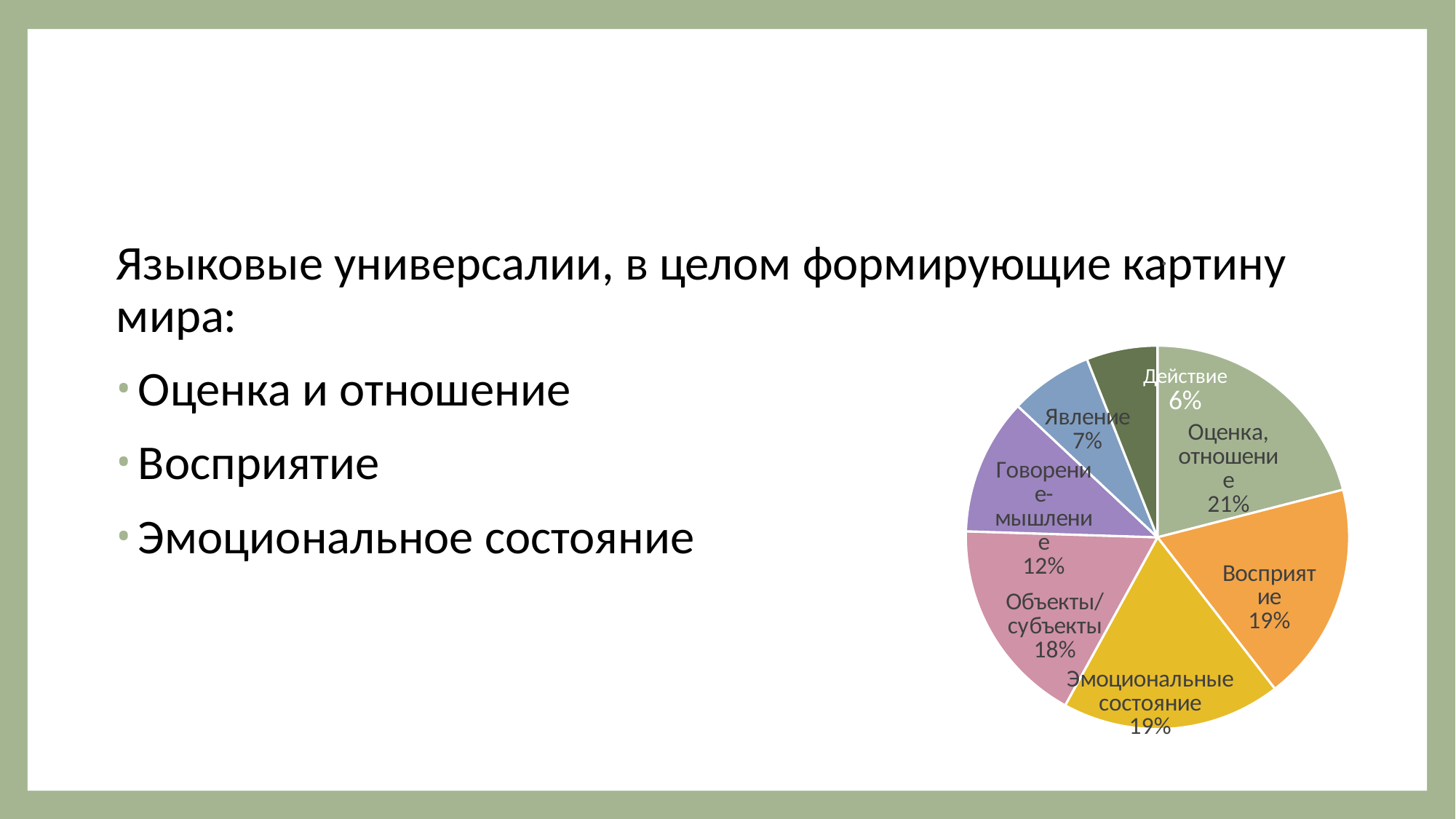
What kind of chart is shown on the slide? Pie chart What colour is the slice for "Восприятие" in the pie chart? Orange What is the value shown for "Говорение-мышление" in the pie chart? 12% What is the difference in percentage points between "Оценка, отношение" and "Действие"? 15 What is the value shown for "Явление" in the pie chart? 7% Which slice of the pie chart is the smallest? Действие What share of the pie does the slice "Оценка, отношение" represent? 21% What share of the pie does the slice "Восприятие" represent? 19% How many slices does the pie chart have? 7 Which slice of the pie chart is the largest? Оценка, отношение What is the value shown for "Действие" in the pie chart? 6% Which is larger: the slice for "Объекты/субъекты" or the slice for "Говорение-мышление"? Объекты/субъекты